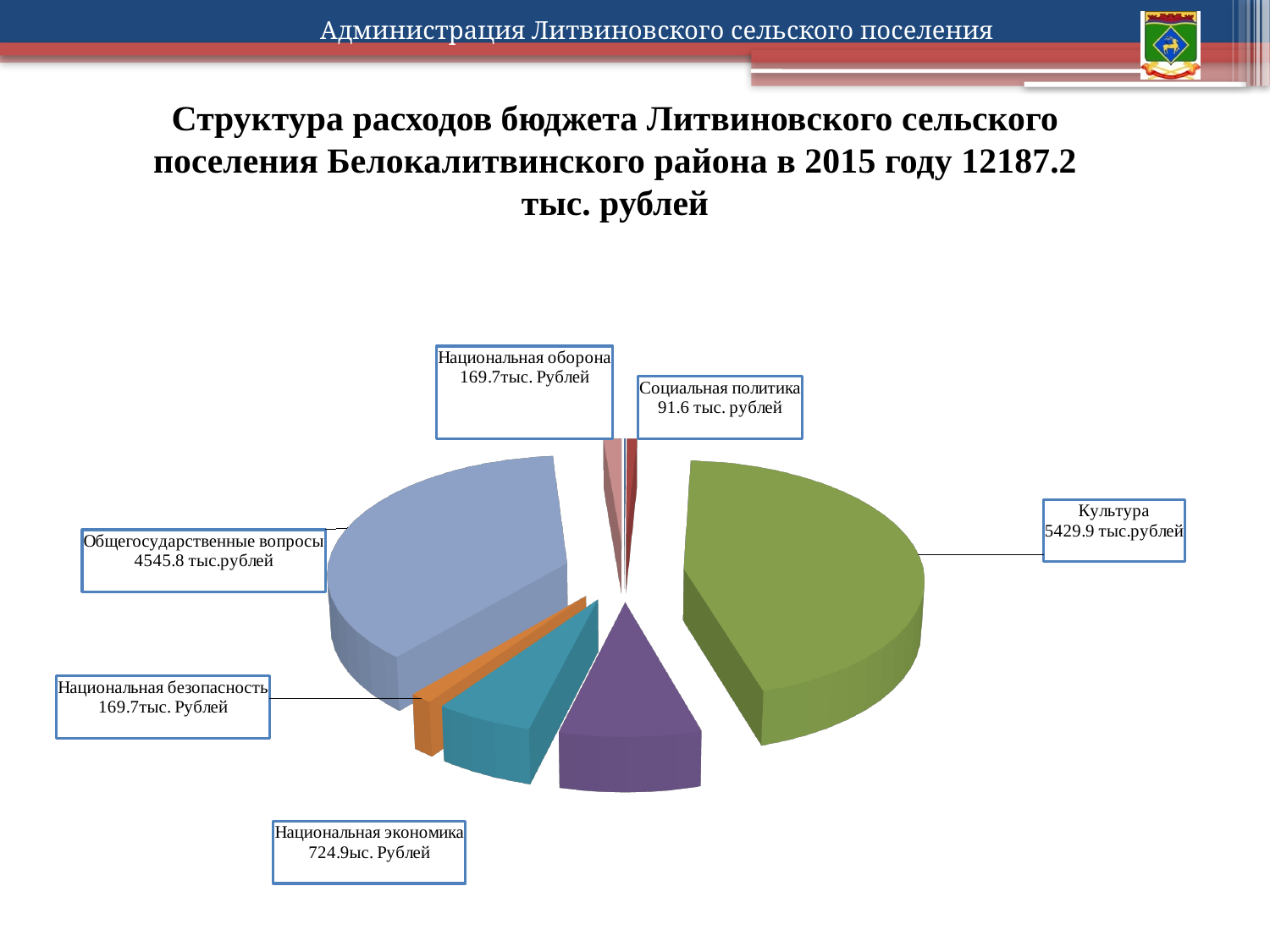
Which category has the largest slice of the pie? Культура What is the value shown for Социальная политика? 91.6 тыс. рублей Which labelled category has the smallest value? Социальная политика What is the value shown for Национальная экономика? 724.9 тыс. Рублей What kind of chart is shown on the slide? pie chart Which is larger, Культура or Общегосударственные вопросы? Культура What is the value shown for Национальная оборона? 169.7 тыс. Рублей What total budget expenditure for 2015 is stated in the chart title? 12187.2 тыс. рублей What is the value shown for Общегосударственные вопросы? 4545.8 тыс.рублей What is the difference between the values for Культура and Общегосударственные вопросы? 884.1 тыс. рублей What is the value shown for Культура? 5429.9 тыс.рублей What is the difference between the values for Национальная экономика and Национальная оборона? 555.2 тыс. рублей